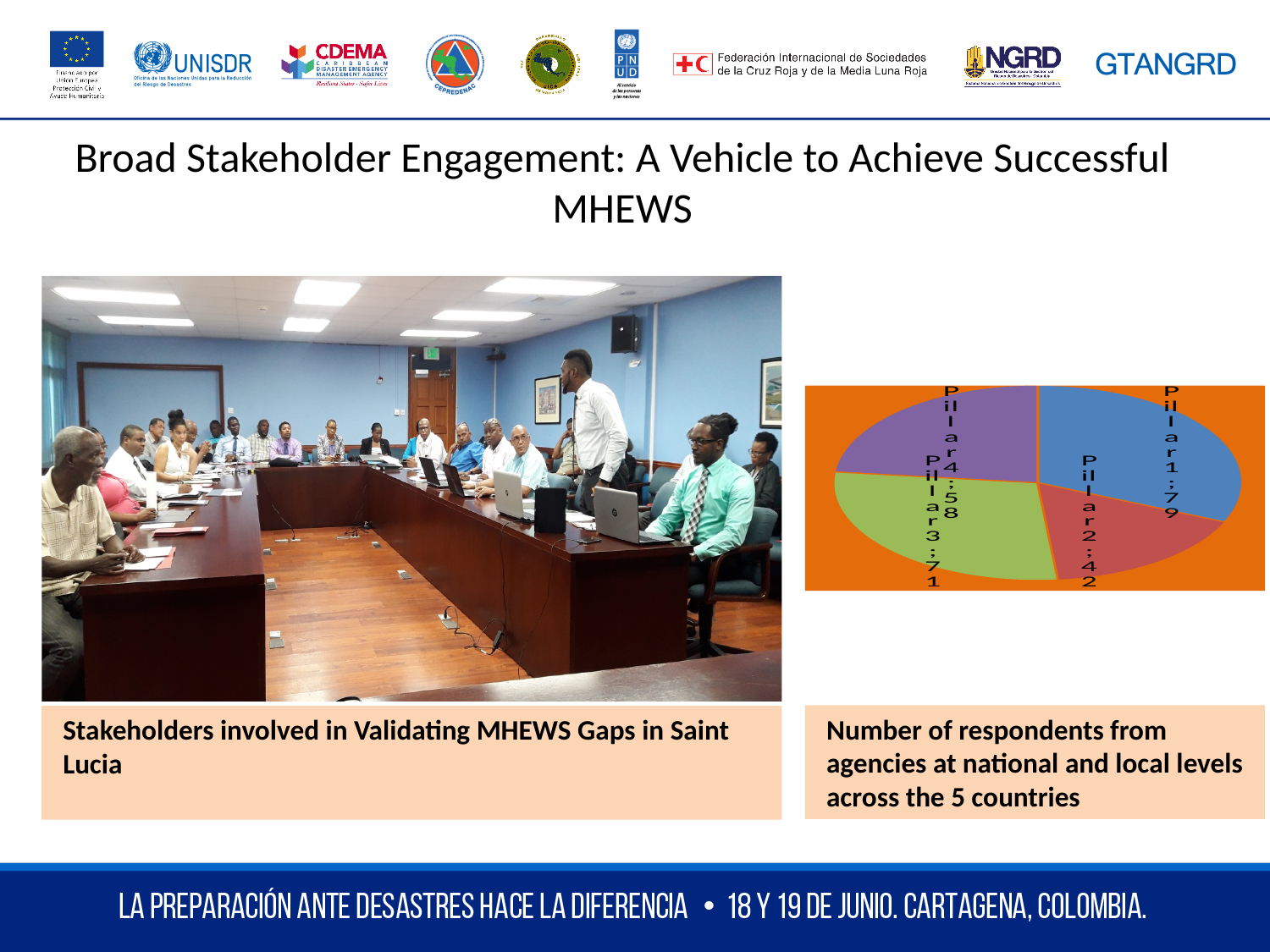
What is the value for Pillar 1 in the pie chart? 79 What is the total of all four pillar values in the pie chart? 250 What colour is the Pillar 1 slice in the pie chart? blue What is the difference between the values for Pillar 1 and Pillar 2? 37 What type of chart is shown on the slide? pie chart What is the value for Pillar 2 in the pie chart? 42 Which pillar has the highest number of respondents in the pie chart? Pillar 1 How many slices does the pie chart have? 4 What is the value for Pillar 4 in the pie chart? 58 What is the value for Pillar 3 in the pie chart? 71 Which pillar has the lowest number of respondents in the pie chart? Pillar 2 Which is larger in the pie chart, Pillar 3 or Pillar 4? Pillar 3